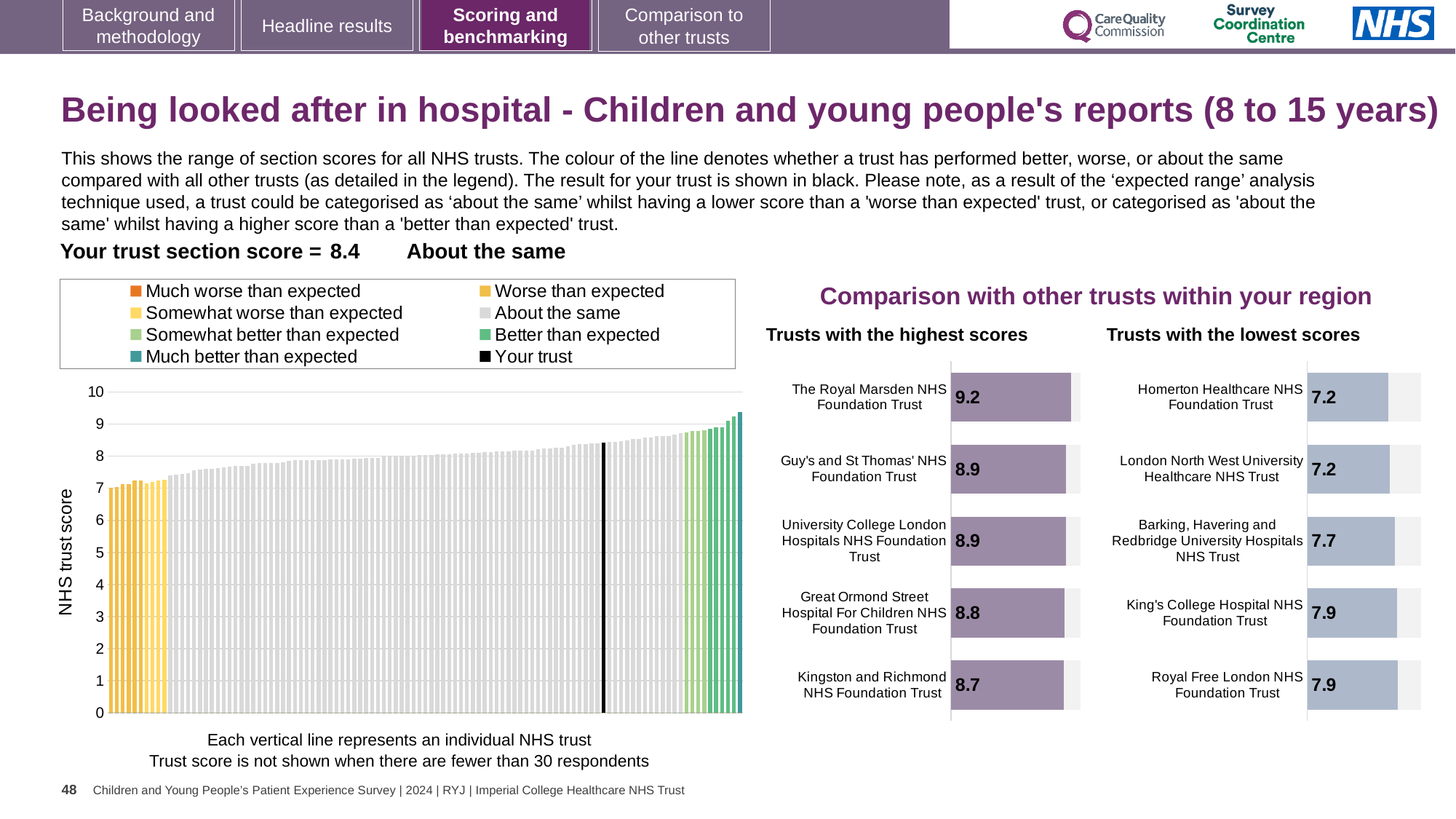
In the 'Trusts with the lowest scores' chart, what is the difference between the scores of Royal Free London NHS Foundation Trust and Homerton Healthcare NHS Foundation Trust? 0.7 In the 'Trusts with the highest scores' chart, what is the score for The Royal Marsden NHS Foundation Trust? 9.2 How many trusts are shown in the 'Trusts with the lowest scores' chart? 5 In the large chart on the left, is the value for 'Your trust' (the black bar) greater or less than 8? greater In the 'Trusts with the highest scores' chart, which trust has the highest score? The Royal Marsden NHS Foundation Trust In the 'Trusts with the highest scores' chart, what is the difference between the scores of The Royal Marsden NHS Foundation Trust and Kingston and Richmond NHS Foundation Trust? 0.5 In the 'Trusts with the highest scores' chart, which trust has the lowest score? Kingston and Richmond NHS Foundation Trust What kind of chart is the large chart on the left showing NHS trust scores? bar chart In the 'Trusts with the lowest scores' chart, what is the score for Barking, Havering and Redbridge University Hospitals NHS Trust? 7.7 In the 'Trusts with the highest scores' chart, which has the larger score: Guy's and St Thomas' NHS Foundation Trust or Great Ormond Street Hospital For Children NHS Foundation Trust? Guy's and St Thomas' NHS Foundation Trust In the 'Trusts with the lowest scores' chart, which has the larger score: Barking, Havering and Redbridge University Hospitals NHS Trust or King's College Hospital NHS Foundation Trust? King's College Hospital NHS Foundation Trust How many entries does the legend of the large chart on the left list? 8